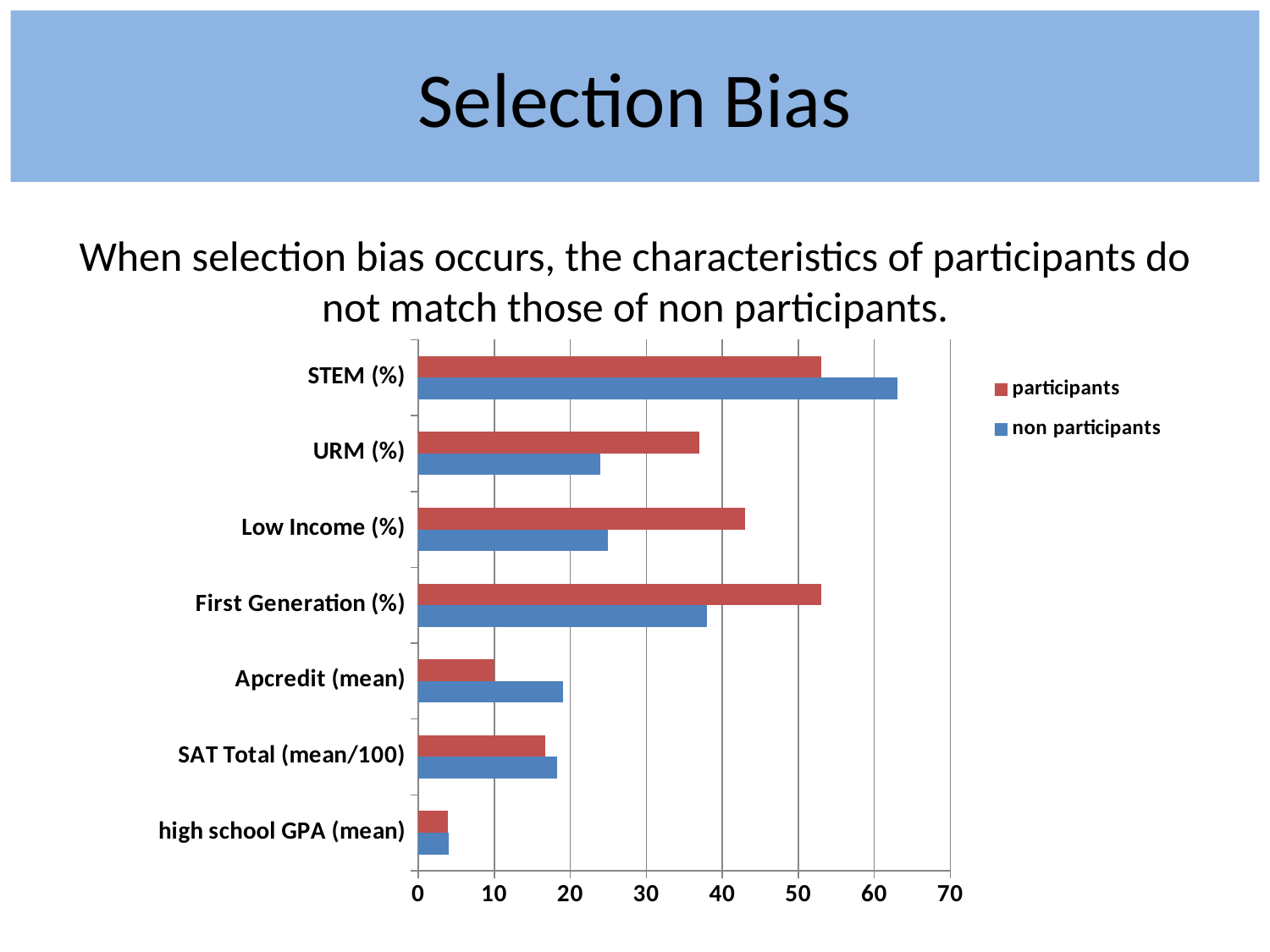
What colour are the bars for the participants series? red For STEM (%), which series has the larger value, participants or non participants? non participants What kind of chart is shown on the slide? bar chart Which category has the lowest value for participants? high school GPA (mean) Is the value for participants in Low Income (%) greater or less than 40? greater Which category has the lowest value for non participants? high school GPA (mean) Which category has the highest value for non participants? STEM (%) How many series does the legend list? 2 Is the value for non participants in STEM (%) greater or less than 60? greater For URM (%), which series has the larger value, participants or non participants? participants For Apcredit (mean), which series has the larger value, participants or non participants? non participants How many categories are shown on the chart? 7